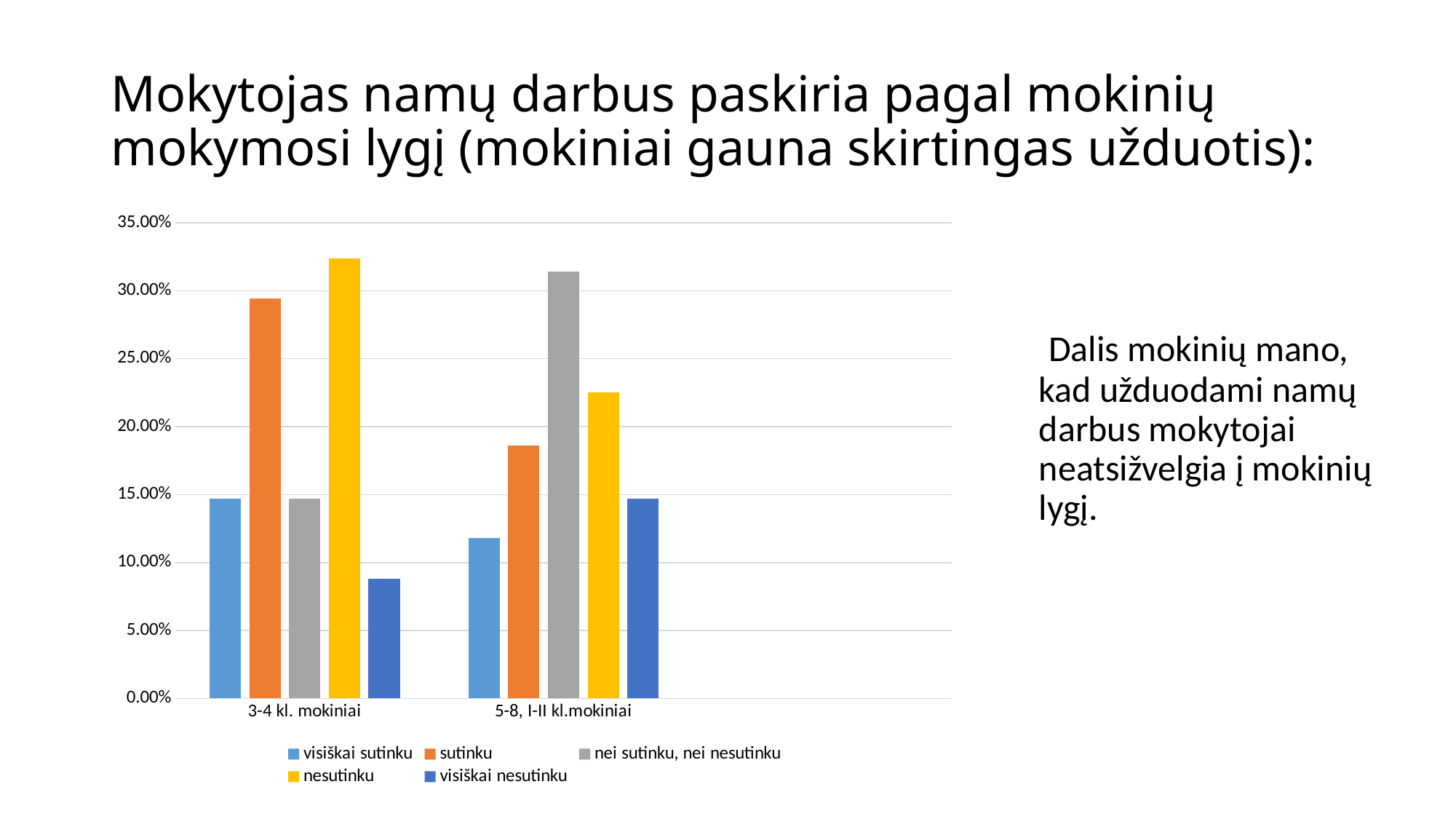
How many categories are shown on the x axis? 2 Is the value for sutinku among 3-4 kl. mokiniai greater or less than 25.00%? greater Which colour represents the series nei sutinku, nei nesutinku? grey Which series has the lowest value for 3-4 kl. mokiniai? visiškai nesutinku What kind of chart is shown on the slide? bar chart Which category has the larger value for nesutinku: 3-4 kl. mokiniai or 5-8, I-II kl.mokiniai? 3-4 kl. mokiniai Which series has the highest value for 5-8, I-II kl.mokiniai? nei sutinku, nei nesutinku Which series has the highest value for 3-4 kl. mokiniai? nesutinku How many series does the legend list? 5 Which series has the lowest value for 5-8, I-II kl.mokiniai? visiškai sutinku Is the value for visiškai nesutinku among 3-4 kl. mokiniai greater or less than 10.00%? less Is the value for nesutinku among 5-8, I-II kl.mokiniai greater or less than 20.00%? greater